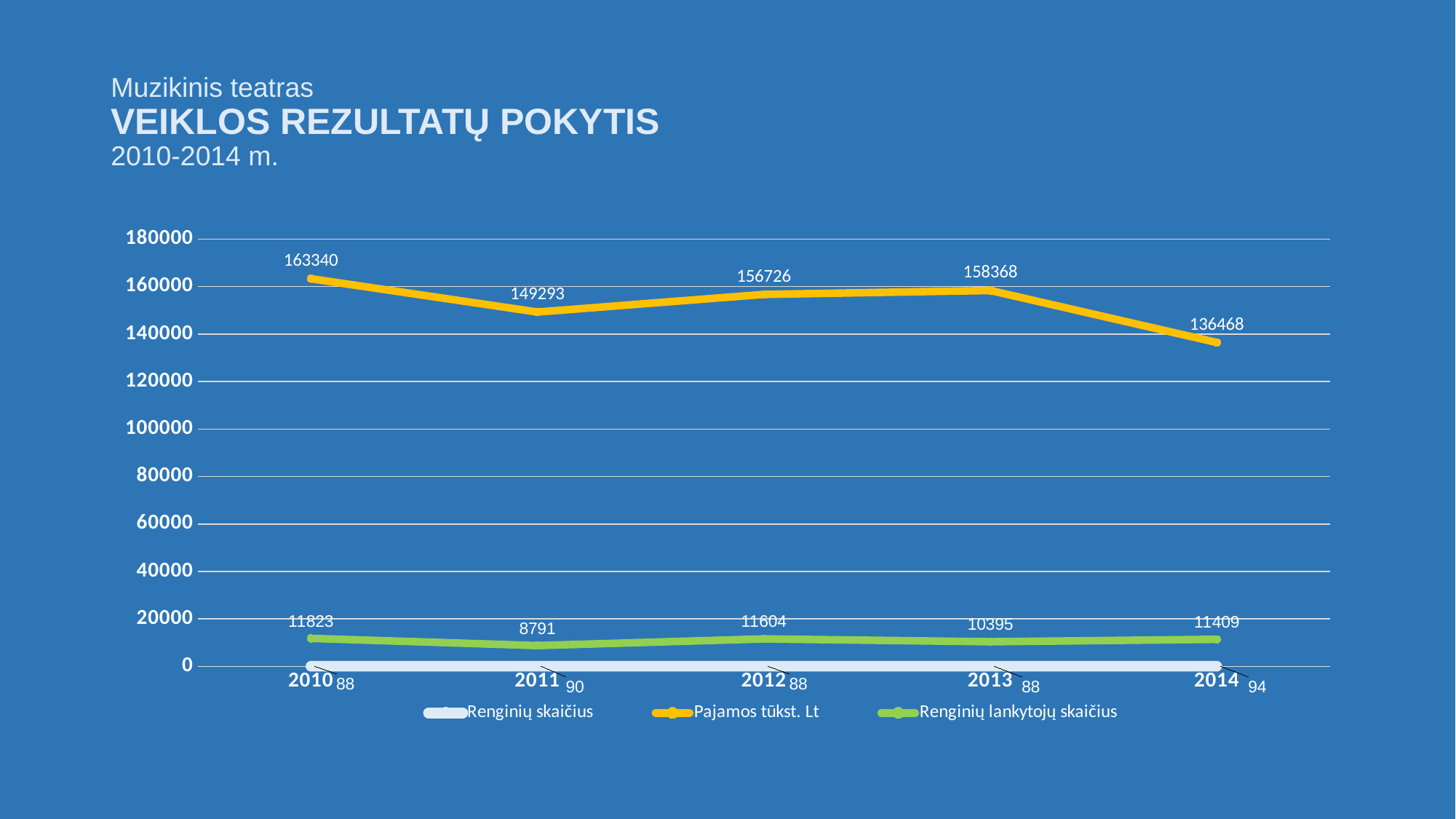
How many series does the legend list? 3 Is the value of Pajamos tūkst. Lt in 2011 greater or less than 160000? less What is the value of Pajamos tūkst. Lt in 2010? 163340 What is the value of Renginių skaičius in 2014? 94 Which is larger: Renginių lankytojų skaičius in 2012 or in 2013? 2012 How many years are plotted along the x axis? 5 What is the difference between Pajamos tūkst. Lt in 2013 and in 2014? 21900 In which year is Pajamos tūkst. Lt the lowest? 2014 What is the value of Renginių lankytojų skaičius in 2011? 8791 What type of chart is shown on the slide? line chart In which year is Renginių lankytojų skaičius the highest? 2010 Which series is drawn in green? Renginių lankytojų skaičius